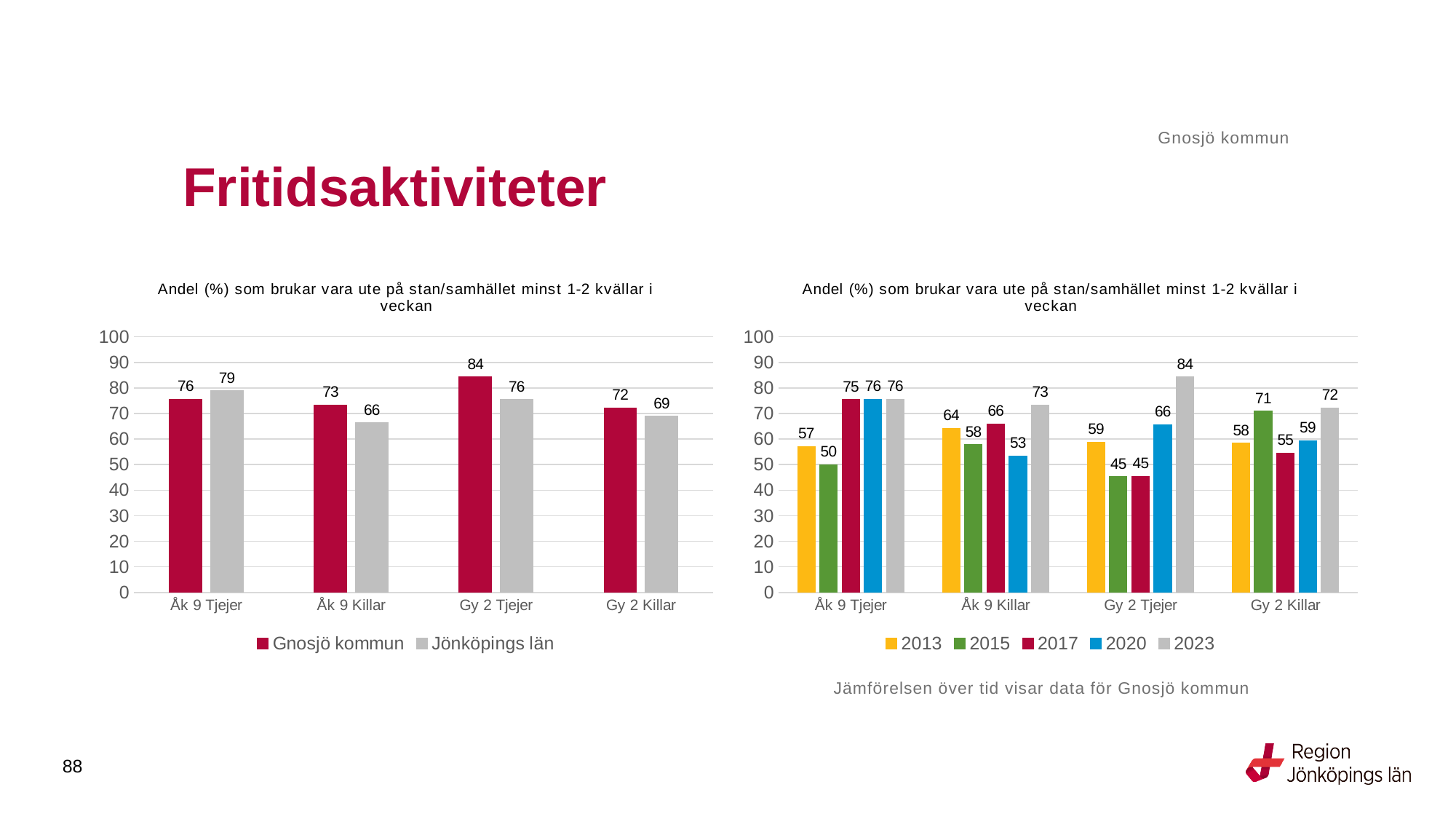
What kind of chart is the right chart? Bar chart In the left chart, which is larger for Åk 9 Tjejer: Gnosjö kommun or Jönköpings län? Jönköpings län In the left chart, what is the value for Gnosjö kommun for Gy 2 Tjejer? 84 In the right chart, which category has the highest value for 2023? Gy 2 Tjejer How many series does the legend of the left chart list? 2 How many series does the legend of the right chart list? 5 In the left chart, what is the difference between Gnosjö kommun and Jönköpings län for Gy 2 Tjejer? 8 In the right chart, what is the value for 2015 for Gy 2 Killar? 71 In the left chart, which category has the lowest value for Gnosjö kommun? Gy 2 Killar In the left chart, what is the value for Jönköpings län for Åk 9 Killar? 66 In the right chart, what is the value for 2020 for Åk 9 Killar? 53 In the right chart, what is the difference between 2023 and 2013 for Gy 2 Tjejer? 25